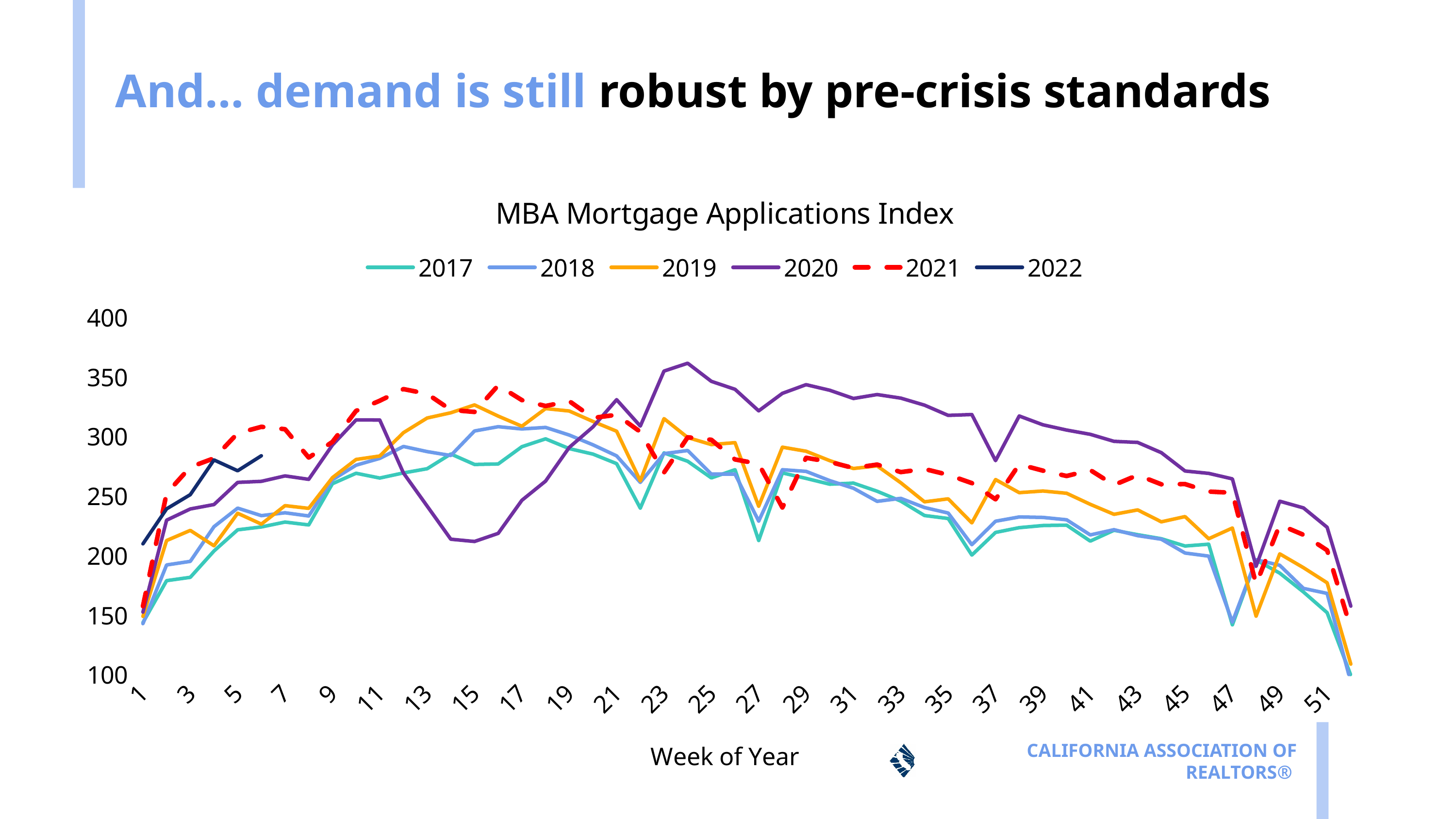
Is the value for 2020 at week 15 greater or less than 250? less Is the value for 2021 at week 16 greater or less than 300? greater What is the title of the chart? MBA Mortgage Applications Index What kind of chart is shown on the slide? line chart Which series has the highest value at week 25? 2020 Which series in the legend is drawn as a dashed line? 2021 Which series has the lowest value at week 15? 2020 Is the value for 2019 at week 52 greater or less than 150? less How many series does the legend list? 6 Does the 2020 series rise or fall from week 11 to week 15? fall